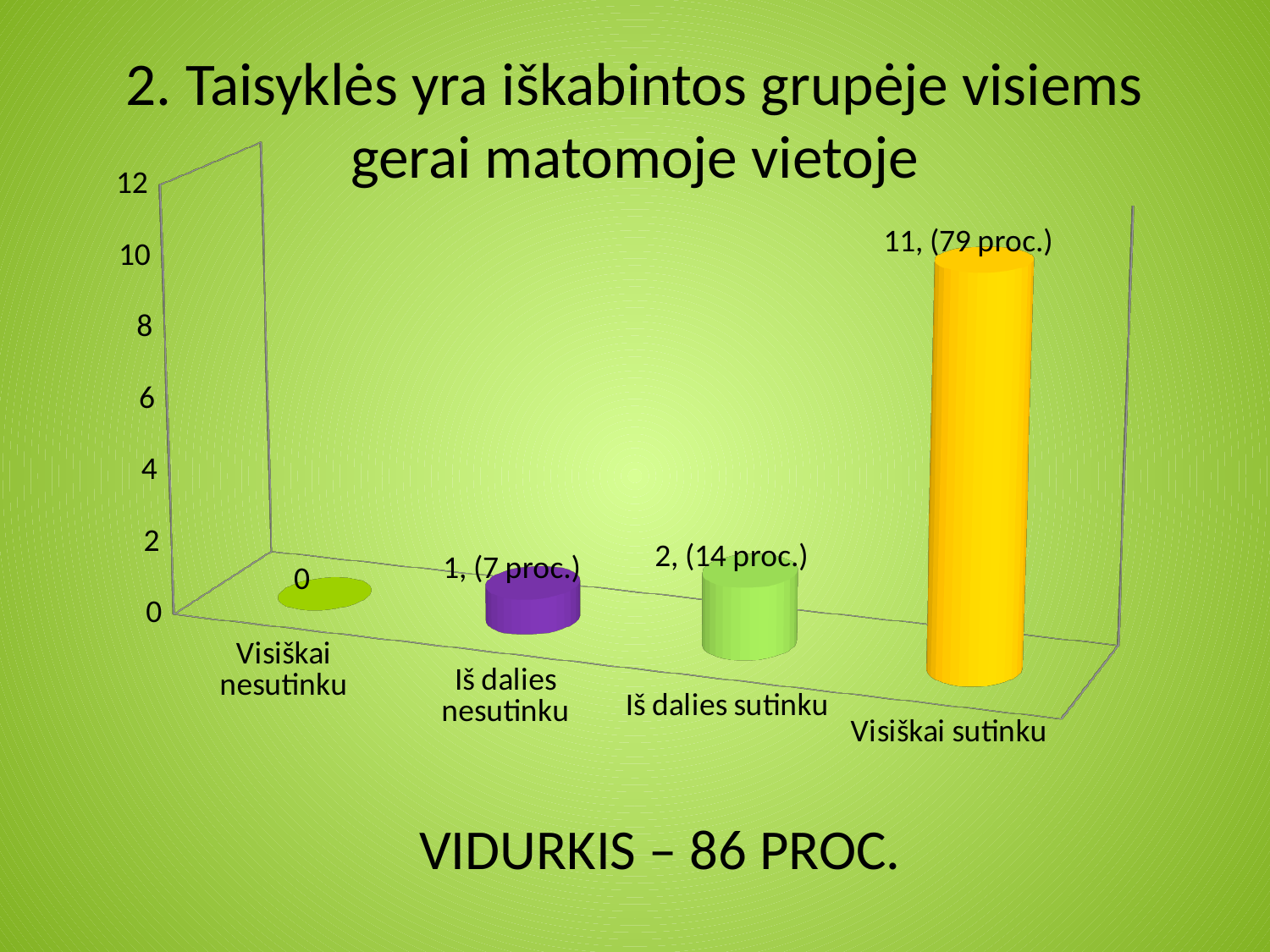
What kind of chart is shown on the slide? bar chart What is the value for "Iš dalies nesutinku"? 1 Is the value for "Visiškai sutinku" greater or less than 10? greater What is the value for "Visiškai nesutinku"? 0 Which is larger, the value for "Iš dalies sutinku" or "Iš dalies nesutinku"? Iš dalies sutinku What is the difference between the values for "Visiškai sutinku" and "Iš dalies sutinku"? 9 What average percentage (VIDURKIS) is stated below the chart? 86 PROC. What percentage is shown for "Iš dalies sutinku"? 14 proc. How many categories are shown on the x axis? 4 Which category has the highest value? Visiškai sutinku Which category has the lowest value? Visiškai nesutinku What is the value for "Visiškai sutinku"? 11